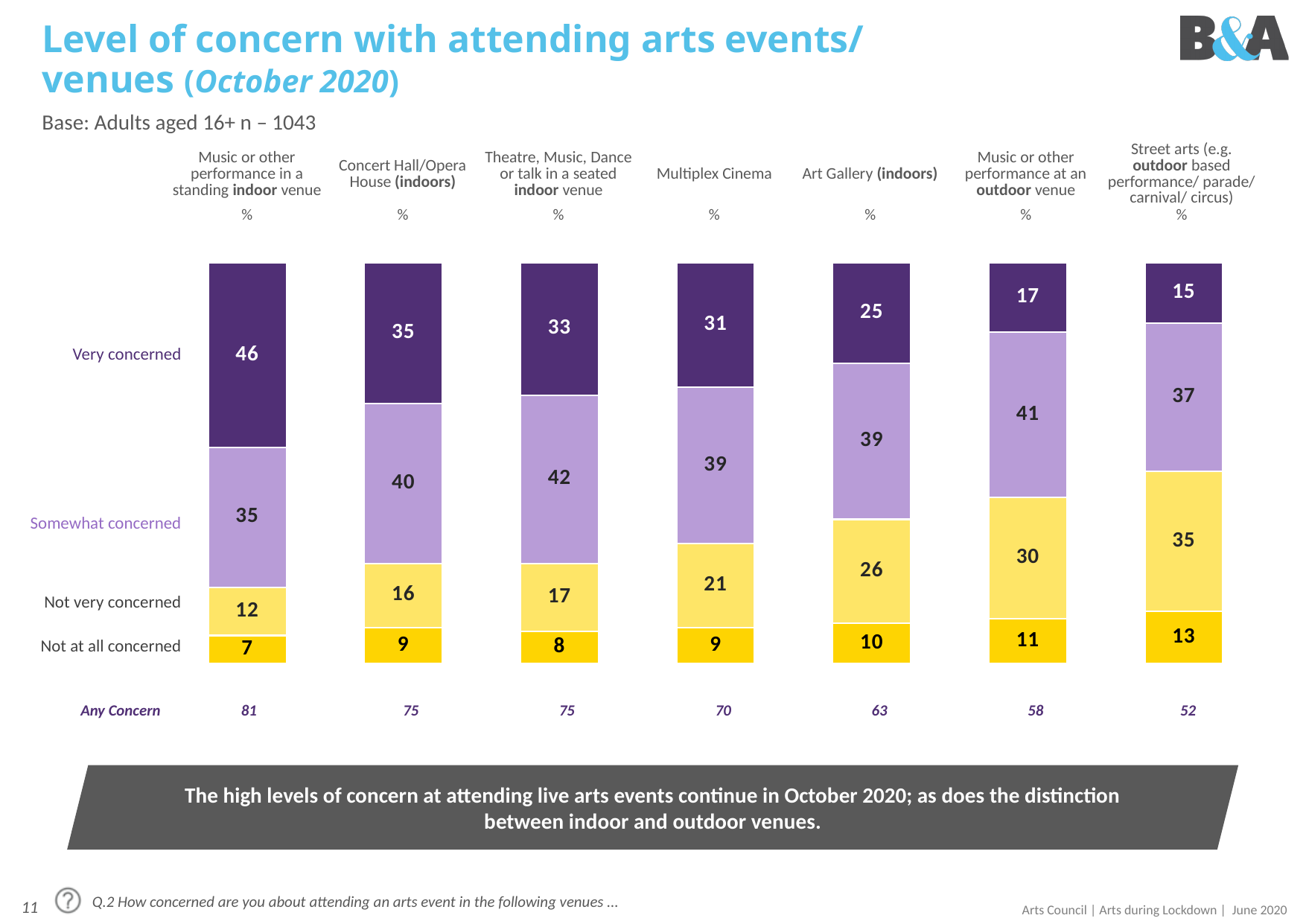
What is the 'Not at all concerned' value for Street arts (e.g. outdoor based performance/ parade/ carnival/ circus)? 13 What is the base sample size stated on the slide? Adults aged 16+ n – 1043 What is the 'Any Concern' figure for Theatre, Music, Dance or talk in a seated indoor venue? 75 What is the 'Somewhat concerned' value for Art Gallery (indoors)? 39 What percentage of adults are very concerned about attending a Multiplex Cinema? 31 What type of chart is shown on the slide? Stacked bar chart How many venue categories are shown in the chart? 7 How many concern levels (series) are shown in the stacked bars? 4 Which venue has the lowest 'Very concerned' value? Street arts (e.g. outdoor based performance/ parade/ carnival/ circus) Which is larger: the 'Not very concerned' value for Multiplex Cinema or for Art Gallery (indoors)? Art Gallery (indoors) What is the difference between the 'Very concerned' values for Concert Hall/Opera House (indoors) and Music or other performance at an outdoor venue? 18 Which venue has the highest 'Very concerned' value? Music or other performance in a standing indoor venue